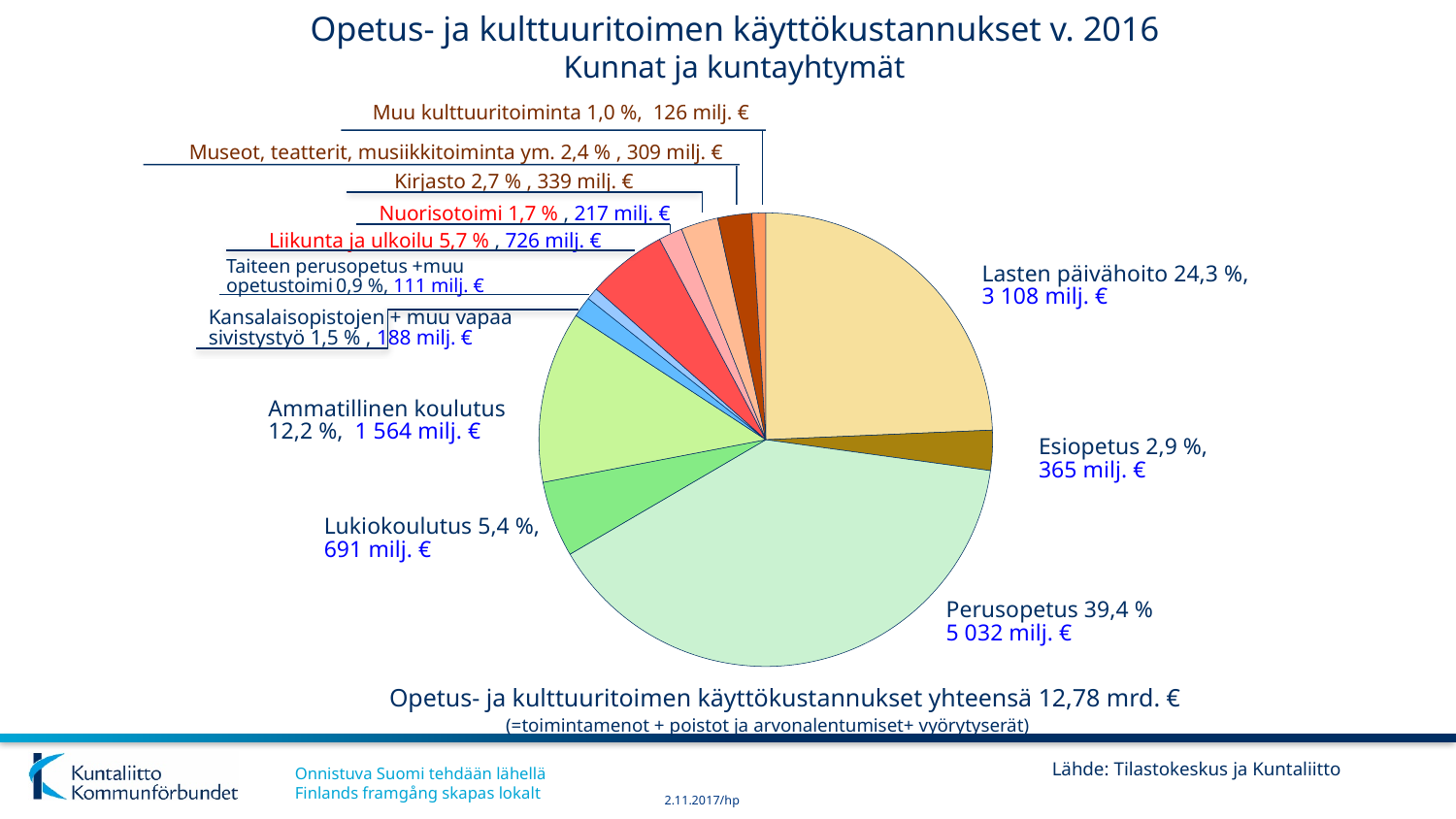
Which category has the largest slice of the pie? Perusopetus What kind of chart is shown on the slide? Pie chart How many slices does the pie chart have? 12 What is the value in milj. € for Ammatillinen koulutus? 1 564 milj. € What is the difference in milj. € between Perusopetus and Lasten päivähoito? 1 924 milj. € What is the value in milj. € for Lasten päivähoito? 3 108 milj. € What is the total of Opetus- ja kulttuuritoimen käyttökustannukset stated on the slide? 12,78 mrd. € What share of the pie does Lukiokoulutus represent? 5,4 % What share of the pie does Kirjasto represent? 2,7 % Which is larger, Liikunta ja ulkoilu or Lukiokoulutus? Liikunta ja ulkoilu Which category has the smallest slice of the pie? Taiteen perusopetus + muu opetustoimi What is the value in milj. € for Perusopetus? 5 032 milj. €